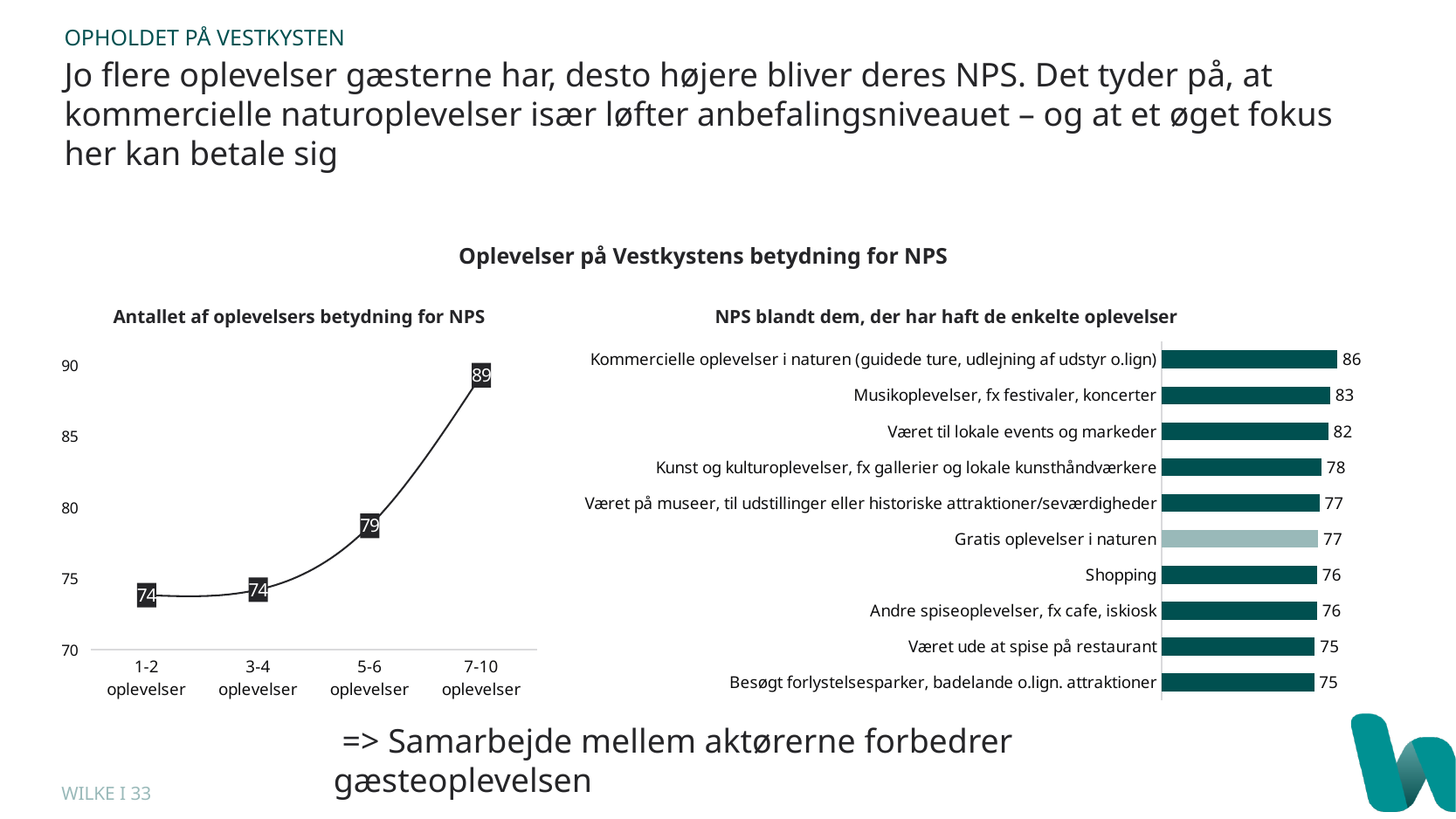
How many categories are shown on the x axis of the chart 'Antallet af oplevelsers betydning for NPS'? 4 In the chart 'Antallet af oplevelsers betydning for NPS', do the values rise or fall from left to right along the x axis? rise In the chart 'NPS blandt dem, der har haft de enkelte oplevelser', what is the difference between the NPS for 'Kommercielle oplevelser i naturen' and 'Gratis oplevelser i naturen'? 9 In the chart 'Antallet af oplevelsers betydning for NPS', what is the difference in NPS between 7-10 oplevelser and 1-2 oplevelser? 15 In the chart 'NPS blandt dem, der har haft de enkelte oplevelser', what is the NPS for 'Musikoplevelser, fx festivaler, koncerter'? 83 What kind of chart is 'NPS blandt dem, der har haft de enkelte oplevelser'? bar chart In the chart 'NPS blandt dem, der har haft de enkelte oplevelser', what is the NPS for 'Gratis oplevelser i naturen'? 77 In the chart 'NPS blandt dem, der har haft de enkelte oplevelser', how many categories are shown? 10 In the chart 'Antallet af oplevelsers betydning for NPS', what is the NPS for 7-10 oplevelser? 89 What kind of chart is 'Antallet af oplevelsers betydning for NPS'? line chart In the chart 'NPS blandt dem, der har haft de enkelte oplevelser', which category has the highest NPS? Kommercielle oplevelser i naturen (guidede ture, udlejning af udstyr o.lign) In the chart 'Antallet af oplevelsers betydning for NPS', what is the NPS for 5-6 oplevelser? 79